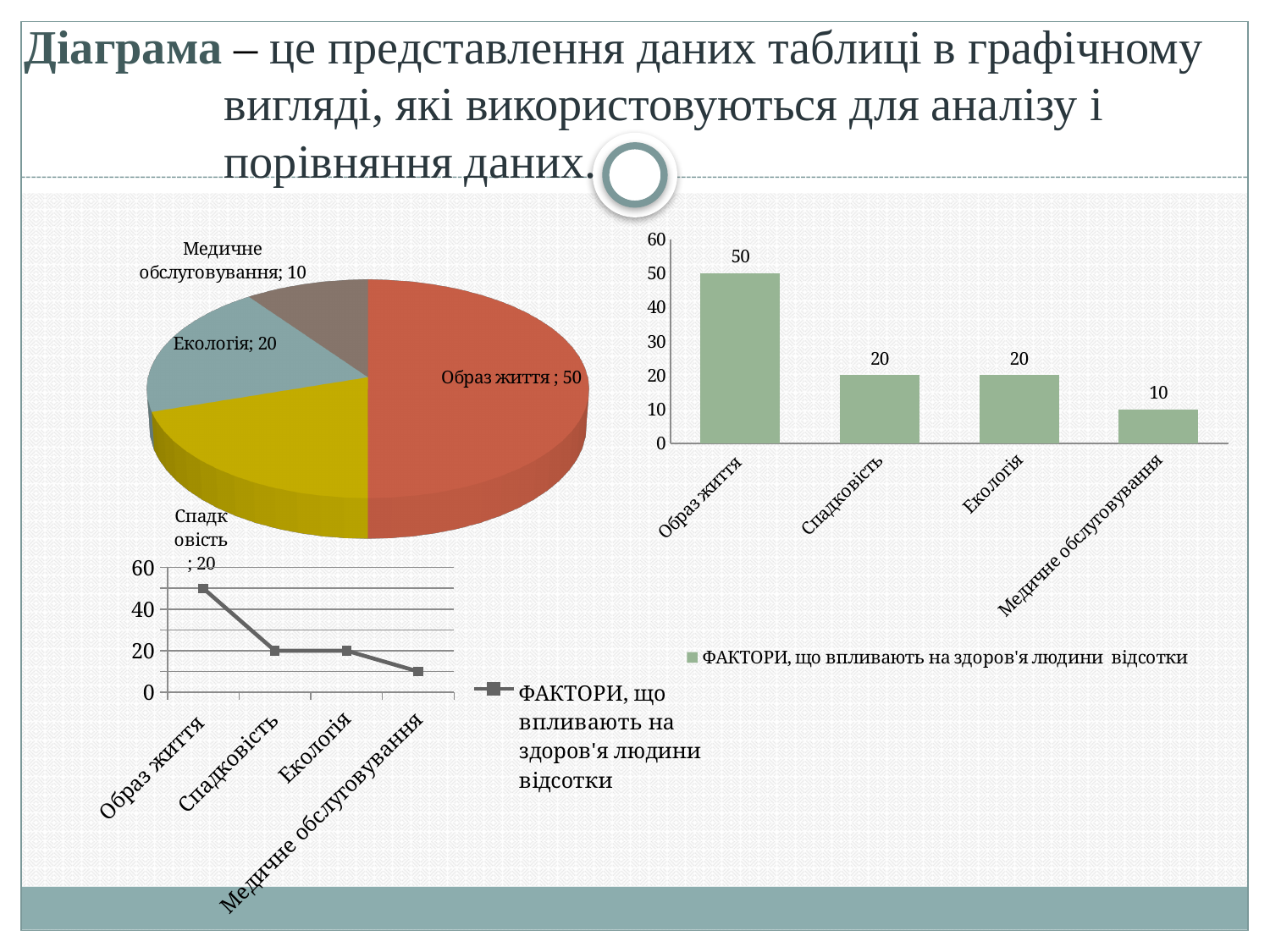
In the pie chart at the top left, which is larger: the value for Екологія or the value for Медичне обслуговування? Екологія In the bar chart at the top right, which category has the lowest value? Медичне обслуговування In the pie chart at the top left, what is the value for Медичне обслуговування? 10 What kind of chart is shown at the bottom left of the slide? line chart In the pie chart at the top left, what share of the total does Образ життя represent? 50% In the bar chart at the top right, which category has the highest value? Образ життя In the bar chart at the top right, what is the difference between the values for Образ життя and Екологія? 30 In the bar chart at the top right, what is the value for Спадковість? 20 In the pie chart at the top left, what is the value for Образ життя? 50 In the line chart at the bottom left, do the values rise or fall from Образ життя to Медичне обслуговування? fall In the bar chart at the top right, how many categories are shown? 4 In the line chart at the bottom left, is the value for Образ життя greater or less than 40? greater